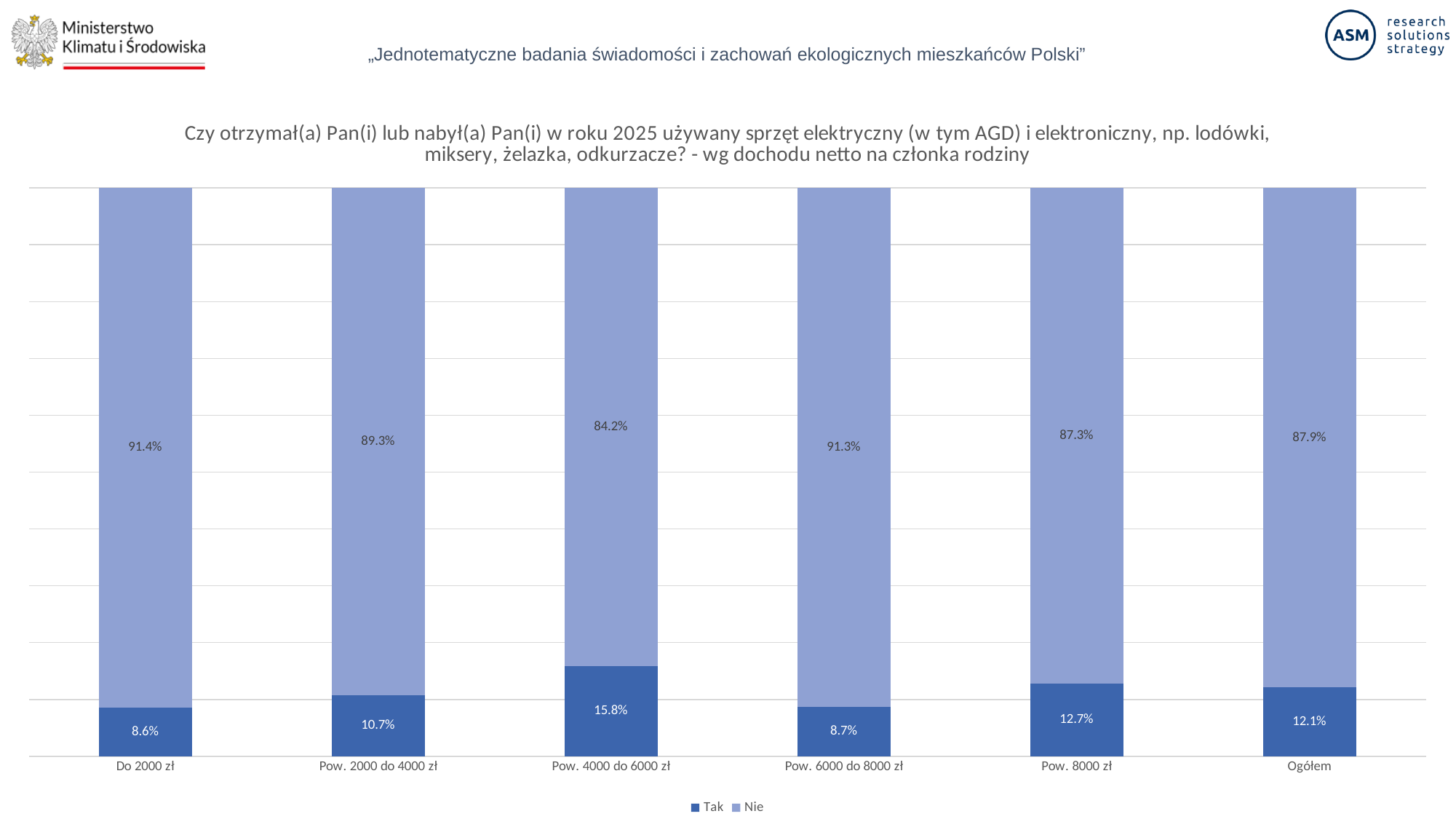
What is the total of the stacked bar for 'Pow. 2000 do 4000 zł'? 100.0% How many categories are shown on the x axis? 6 What is the 'Nie' value for the 'Pow. 4000 do 6000 zł' category? 84.2% Which category has the highest 'Tak' value? Pow. 4000 do 6000 zł Which category has the highest 'Nie' value? Do 2000 zł What is the 'Tak' value for 'Ogółem'? 12.1% How many series does the legend list? 2 What kind of chart is shown on the slide? Stacked bar chart What is the difference between the 'Tak' values for 'Pow. 8000 zł' and 'Pow. 2000 do 4000 zł'? 2.0% What is the 'Tak' value for the 'Do 2000 zł' category? 8.6% Which is larger: the 'Tak' value for 'Pow. 8000 zł' or for 'Pow. 6000 do 8000 zł'? Pow. 8000 zł Which category has the lowest 'Tak' value? Do 2000 zł